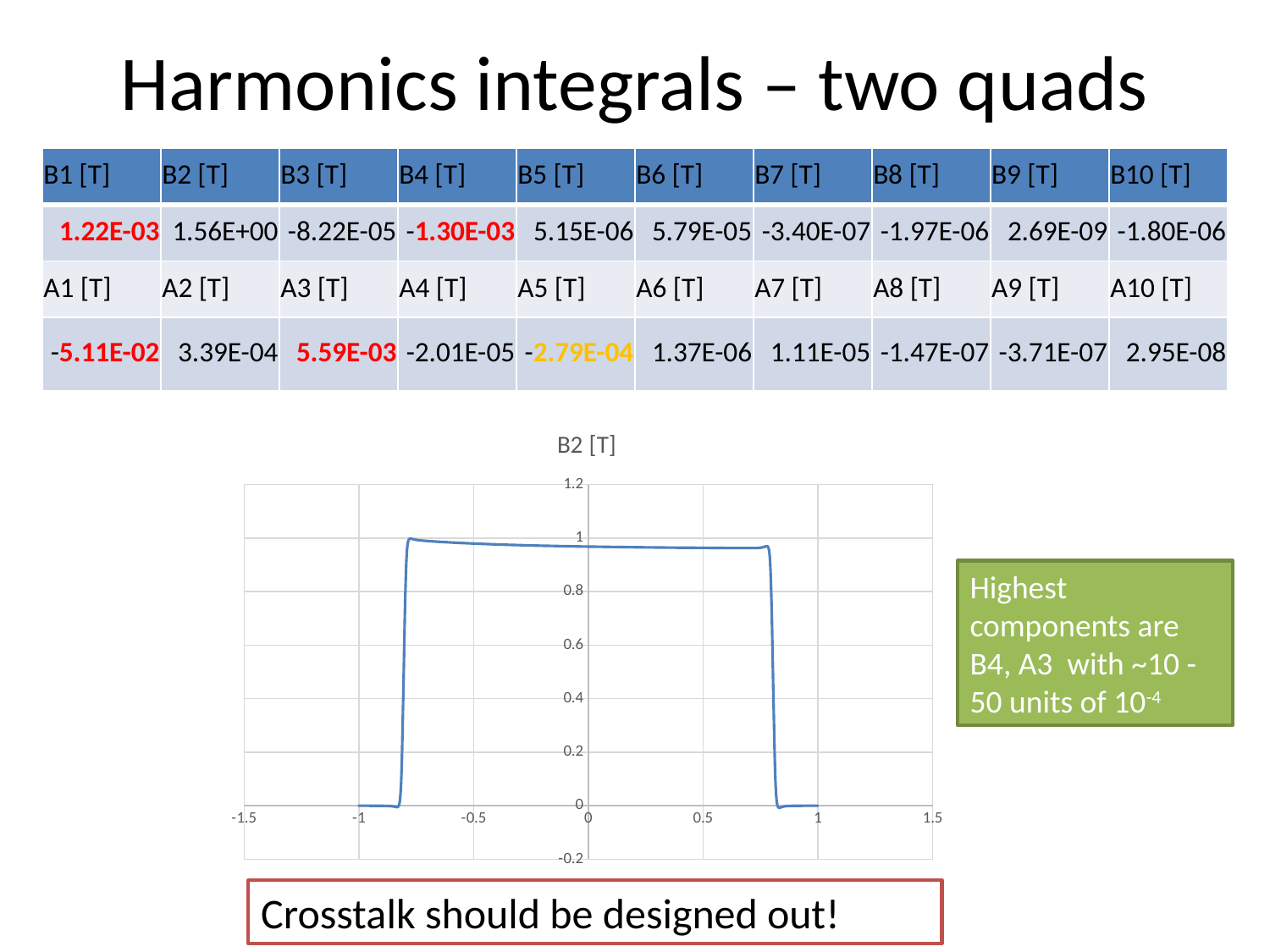
Is the value of the line at x = 1 greater or less than 0.2? less What is the title of the chart on the slide? B2 [T] Is the value of the line at x = -1 greater or less than 0.2? less Is the value of the line at x = 0.5 greater or less than 0.6? greater Which is larger, the value of the line at x = 0 or at x = 1? x = 0 How many lines are plotted on the chart? 1 What is the highest tick value shown on the y axis of the chart? 1.2 What kind of chart is shown on the slide? line chart Does the line rise or fall as x goes from -1 to -0.5? rise Does the line rise or fall as x goes from 0.5 to 1? fall